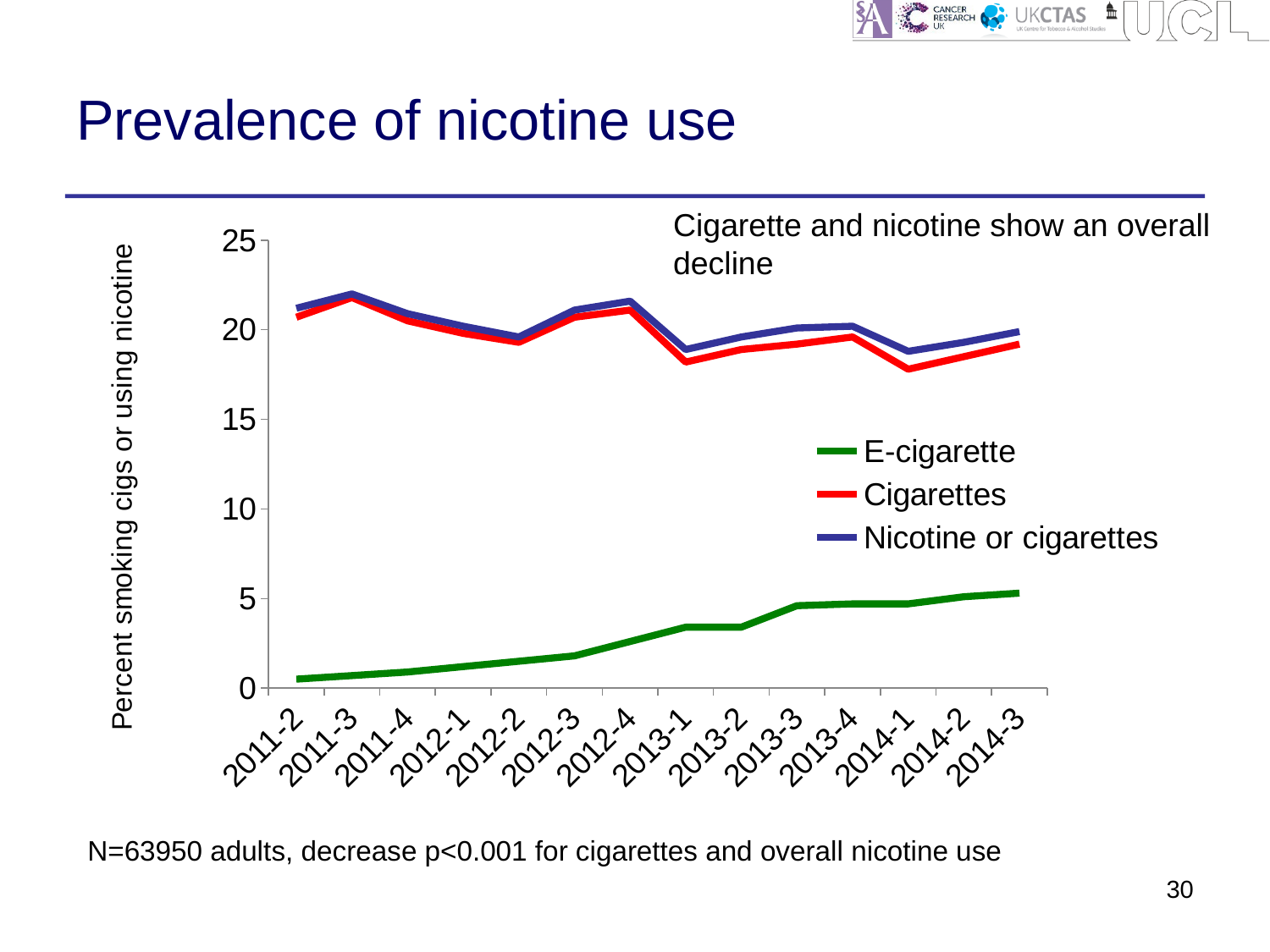
Which series has the lowest values across the whole period? E-cigarette Does the E-cigarette line rise or fall from 2011-2 to 2014-3? rise How many series does the legend list? 3 Is the E-cigarette value for 2014-3 greater or less than 10? less At 2014-3, which is higher: E-cigarette or Cigarettes? Cigarettes Does the Cigarettes line rise or fall overall from 2011-2 to 2014-3? fall Is the Cigarettes value for 2011-3 greater or less than 20? greater How many time periods are plotted along the x axis? 14 Is the Cigarettes value for 2014-1 greater or less than 20? less What is the label on the y axis? Percent smoking cigs or using nicotine In which period is the E-cigarette value highest? 2014-3 What kind of chart is shown on the slide? line chart